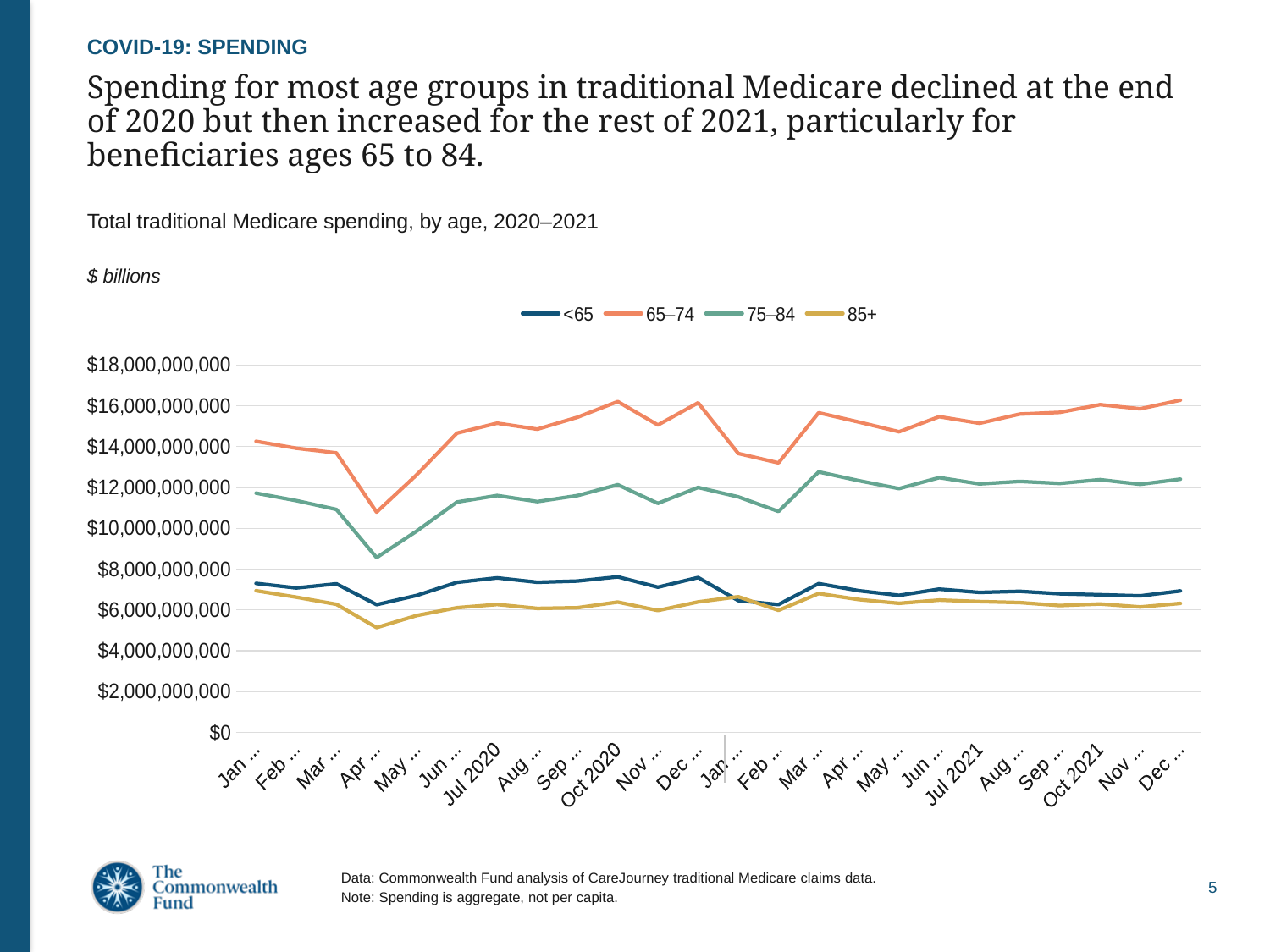
Is the value for the 75–84 group in Oct 2021 greater or less than $10,000,000,000? greater What kind of chart is shown on the slide? Line chart How many monthly data points are plotted along the x axis? 24 In which month of 2020 does the 75–84 line reach its lowest point? April Which age group has the highest spending across the whole period? 65–74 In Oct 2020, which is larger: spending for the <65 group or the 85+ group? <65 How many series does the legend list? 4 Is the value for the 65–74 group in Jul 2020 greater or less than $14,000,000,000? greater Is the value for the <65 group in Jul 2020 greater or less than $8,000,000,000? less Does spending for the 65–74 group rise or fall between Jul 2020 and Oct 2020? Rise Which age group has the lowest spending across the whole period? 85+ What unit is stated for the y axis of the chart? $ billions